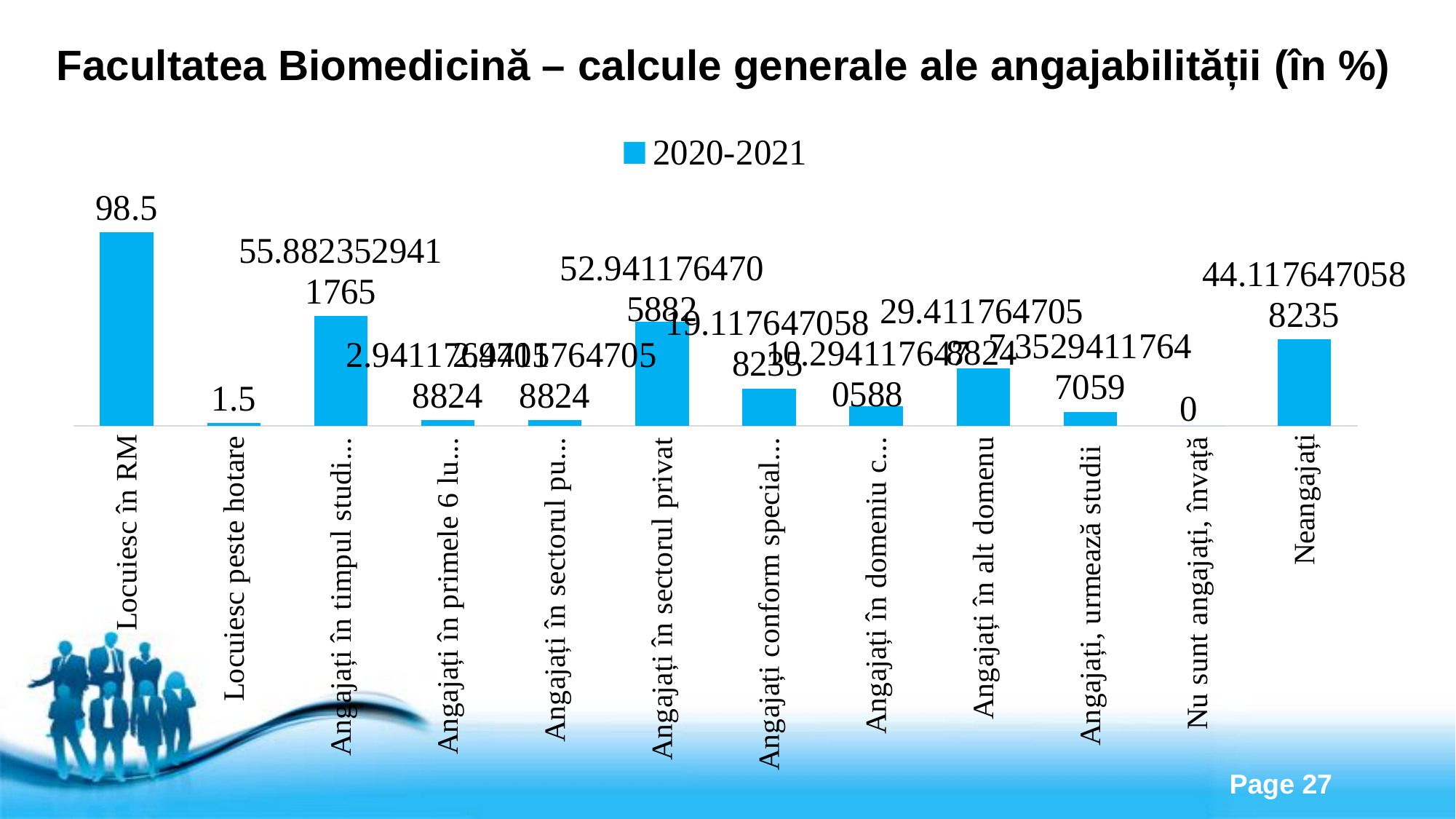
What is the value for Nu sunt angajați, învață? 0 Which is larger, the value for Angajați în alt domenu or the value for Angajați, urmează studii? Angajați în alt domenu What is the value for Locuiesc peste hotare? 1.5 What is the value for Neangajați? 44.1176470588235 How many series does the legend list? 1 Which category has the lowest value? Nu sunt angajați, învață Which category has the highest value? Locuiesc în RM What is the value for Locuiesc în RM? 98.5 What is the value for Angajați în sectorul privat? 52.9411764705882 What is the difference between the values for Locuiesc în RM and Locuiesc peste hotare? 97 How many categories are shown on the x axis? 12 Which is larger, the value for Angajați în sectorul privat or the value for Neangajați? Angajați în sectorul privat